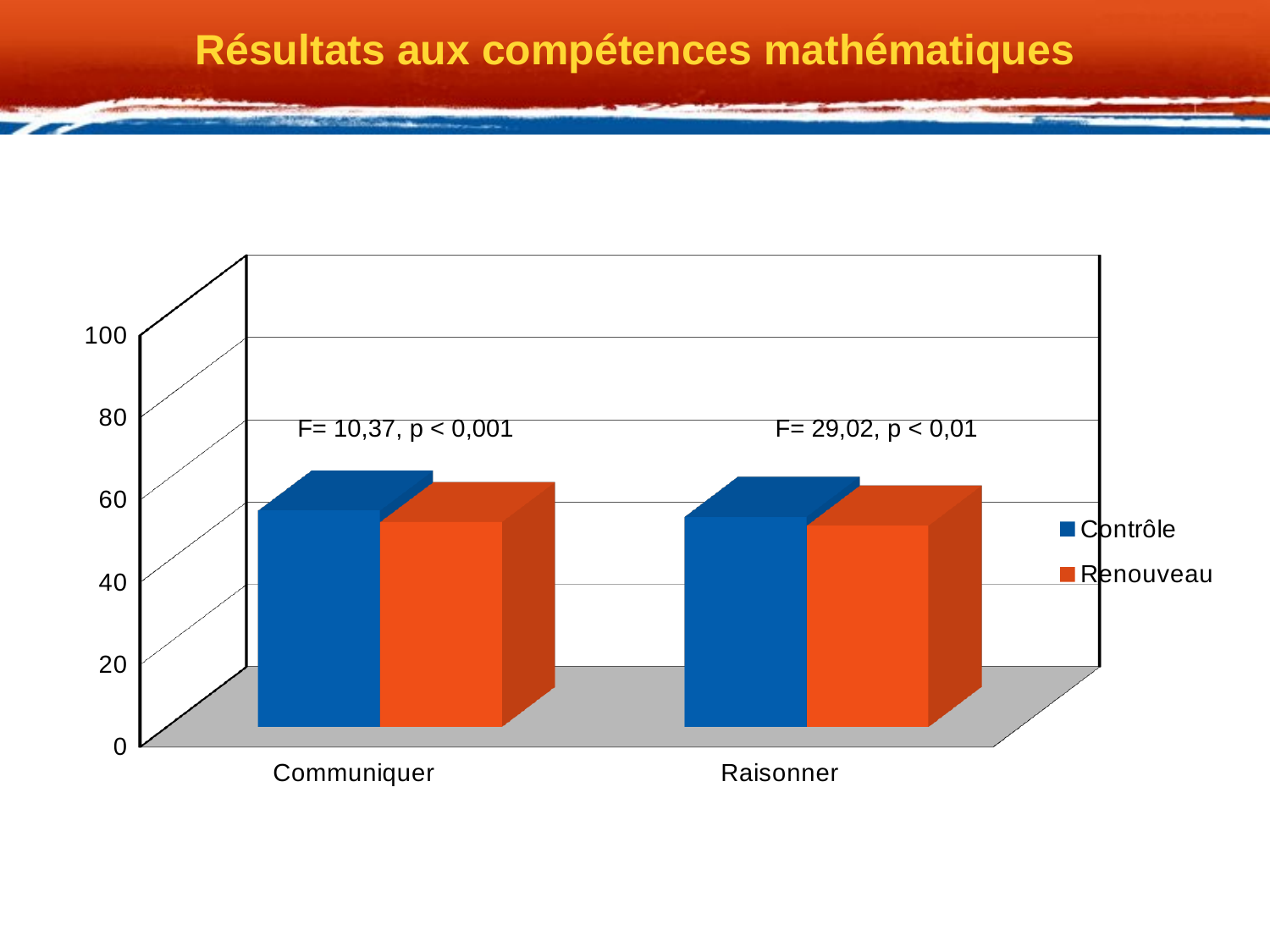
What is the title of the slide containing the chart? Résultats aux compétences mathématiques How many categories are shown on the x axis of the chart? 2 How many series does the legend list? 2 Is the value for Renouveau in the Communiquer category greater or less than 100? less Is the value for Contrôle in the Communiquer category greater or less than 40? greater Is the value for Contrôle in the Raisonner category greater or less than 20? greater What are the two categories on the x axis? Communiquer and Raisonner What kind of chart is shown on the slide? bar chart What is the highest value shown on the vertical axis of the chart? 100 What statistical annotation is printed above the Raisonner bars? F= 29,02, p < 0,01 What are the two series listed in the legend? Contrôle and Renouveau